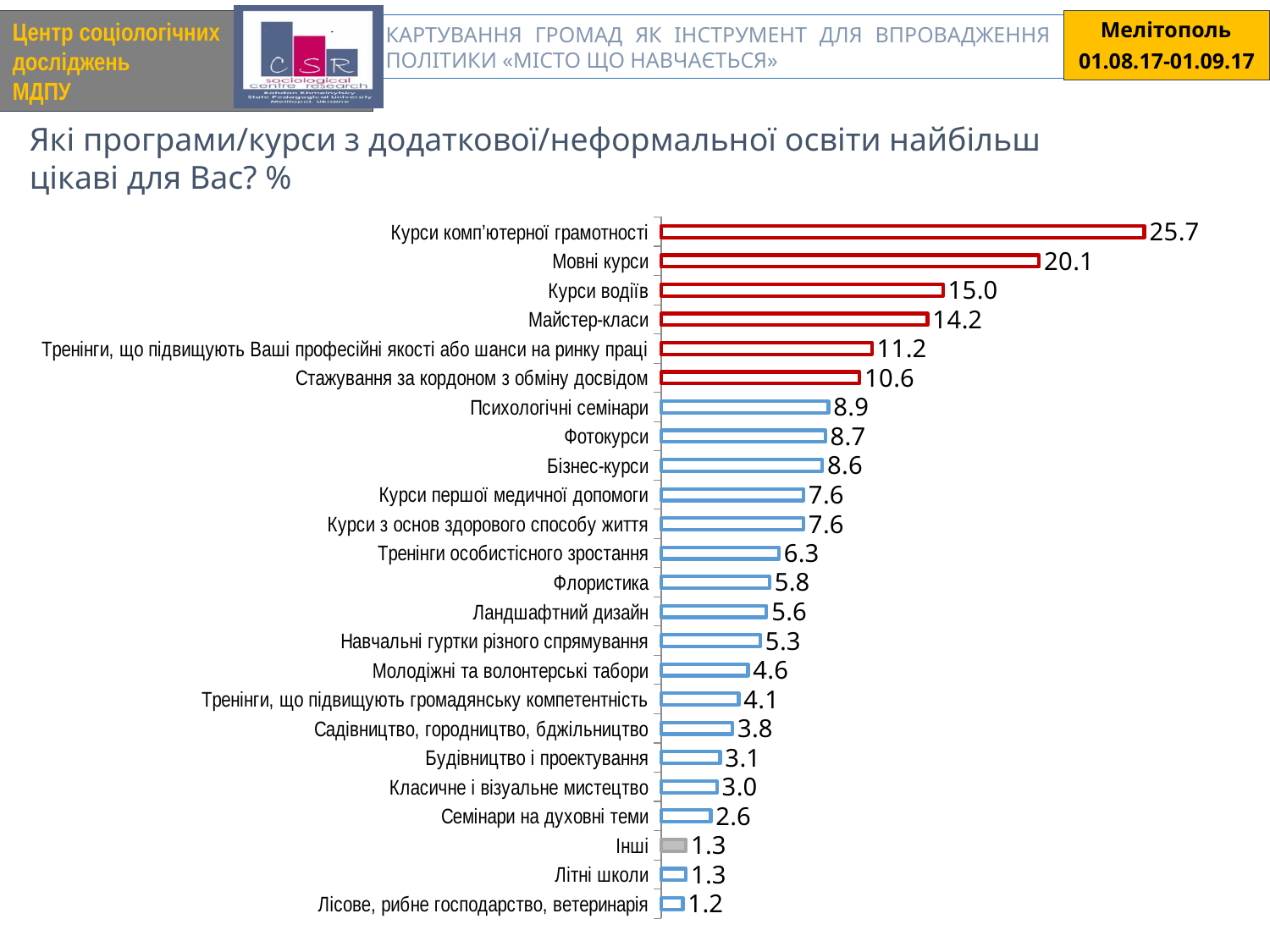
How many categories are shown in the chart? 24 What is the value for Стажування за кордоном з обміну досвідом? 10.6 Which category has the lowest value? Лісове, рибне господарство, ветеринарія What is the difference between the values for Курси водіїв and Майстер-класи? 0.8 What is the value for Семінари на духовні теми? 2.6 Which category has the highest value? Курси комп'ютерної грамотності What is the value for Мовні курси? 20.1 What is the value for Курси комп'ютерної грамотності? 25.7 Which is larger, the value for Психологічні семінари or the value for Бізнес-курси? Психологічні семінари What kind of chart is shown on the slide? Bar chart What is the value for Флористика? 5.8 What is the difference between the values for Курси комп'ютерної грамотності and Мовні курси? 5.6